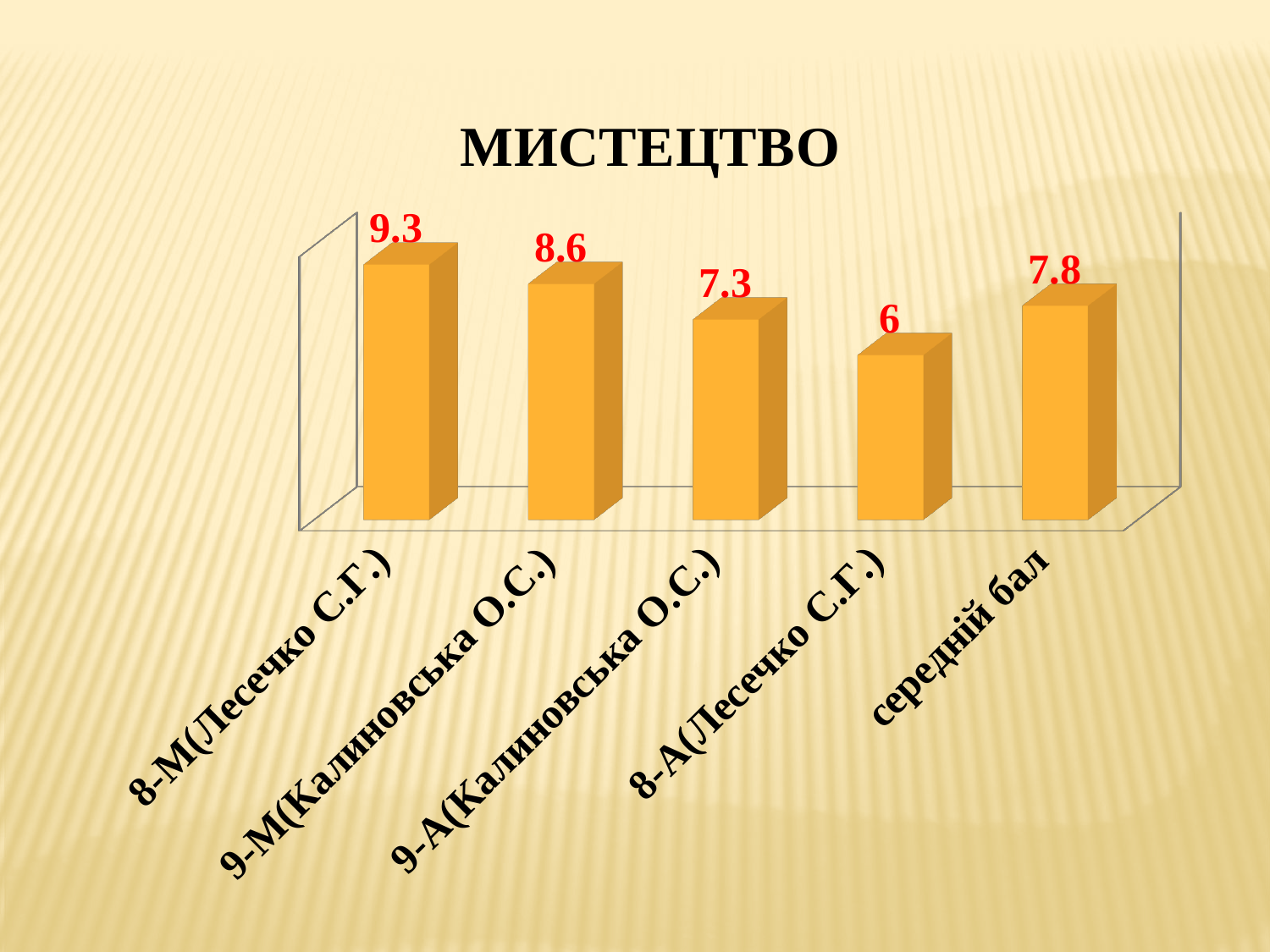
Which is larger, the value for 9-А(Калиновська О.С.) or the value for середній бал? середній бал What kind of chart is shown on the slide? bar chart What is the value for 8-М(Лесечко С.Г.)? 9.3 How many categories are shown in the chart? 5 What is the difference between the values for 8-М(Лесечко С.Г.) and 8-А(Лесечко С.Г.)? 3.3 What is the value for 8-А(Лесечко С.Г.)? 6 What is the title of the chart? МИСТЕЦТВО What is the value for середній бал? 7.8 What is the value for 9-М(Калиновська О.С.)? 8.6 Which category has the highest value? 8-М(Лесечко С.Г.) Which category has the lowest value? 8-А(Лесечко С.Г.) What is the value for 9-А(Калиновська О.С.)? 7.3